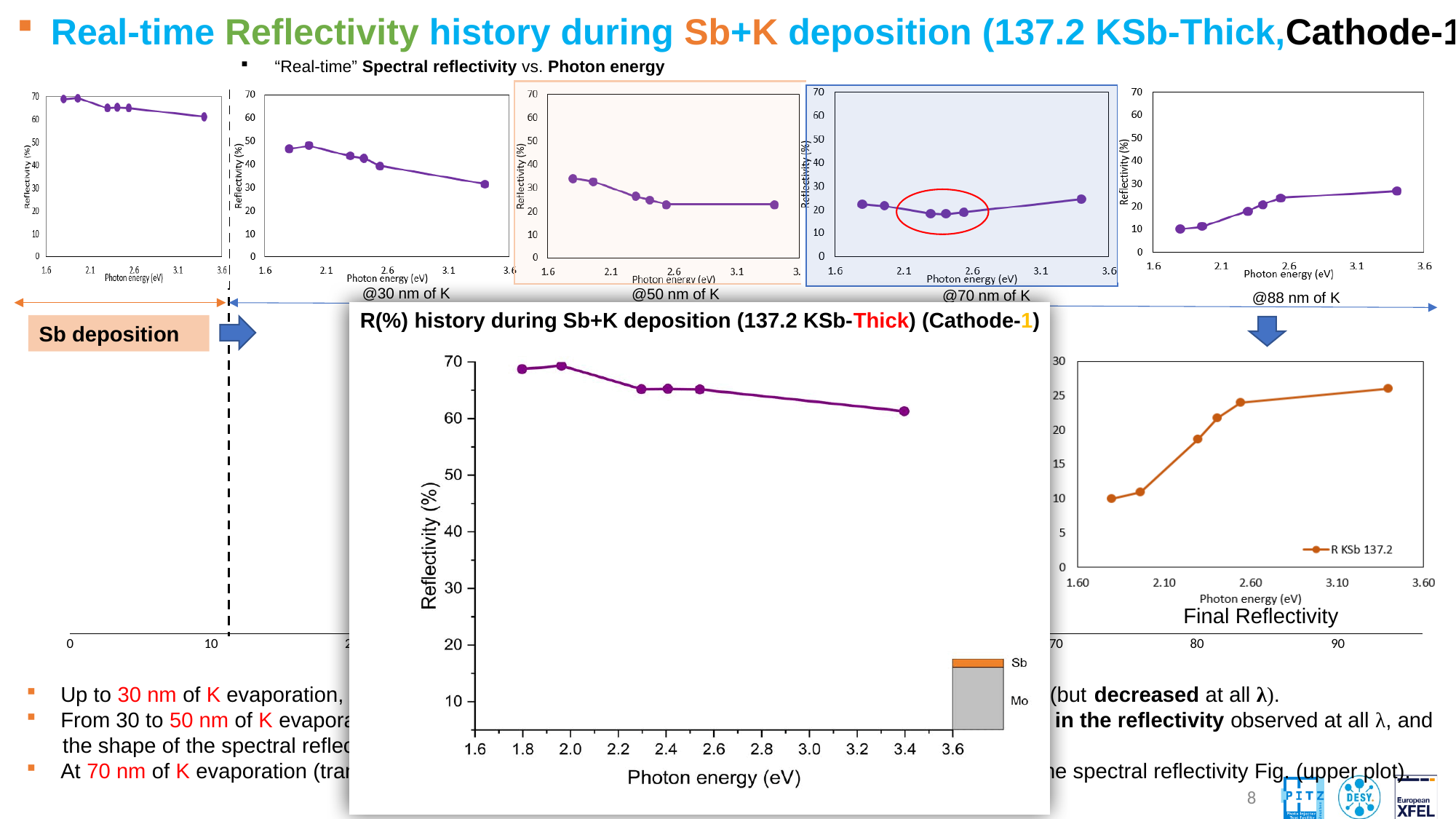
In the top-row chart labelled "@88 nm of K", do the reflectivity values rise or fall as photon energy increases? rise In the large central chart "R(%) history during Sb+K deposition", is the reflectivity at 3.4 eV greater or less than 70? less What is the legend entry in the "Final Reflectivity" chart? R KSb 137.2 In the large central chart "R(%) history during Sb+K deposition", do the reflectivity values rise or fall as photon energy increases? fall In the "Final Reflectivity" chart, is the value at the highest photon energy (about 3.4 eV) greater or less than 20? greater In the "Final Reflectivity" chart, is the value at the lowest photon energy (about 1.8 eV) greater or less than 15? less What is the label on the y-axis of the large central chart "R(%) history during Sb+K deposition"? Reflectivity (%) How many data points are plotted in the large central chart "R(%) history during Sb+K deposition"? 6 What kind of chart is the large central chart titled "R(%) history during Sb+K deposition (137.2 KSb-Thick) (Cathode-1)"? line chart How many series does the legend of the "Final Reflectivity" chart list? 1 In the "Final Reflectivity" chart on the right, do the values rise or fall as photon energy increases? rise